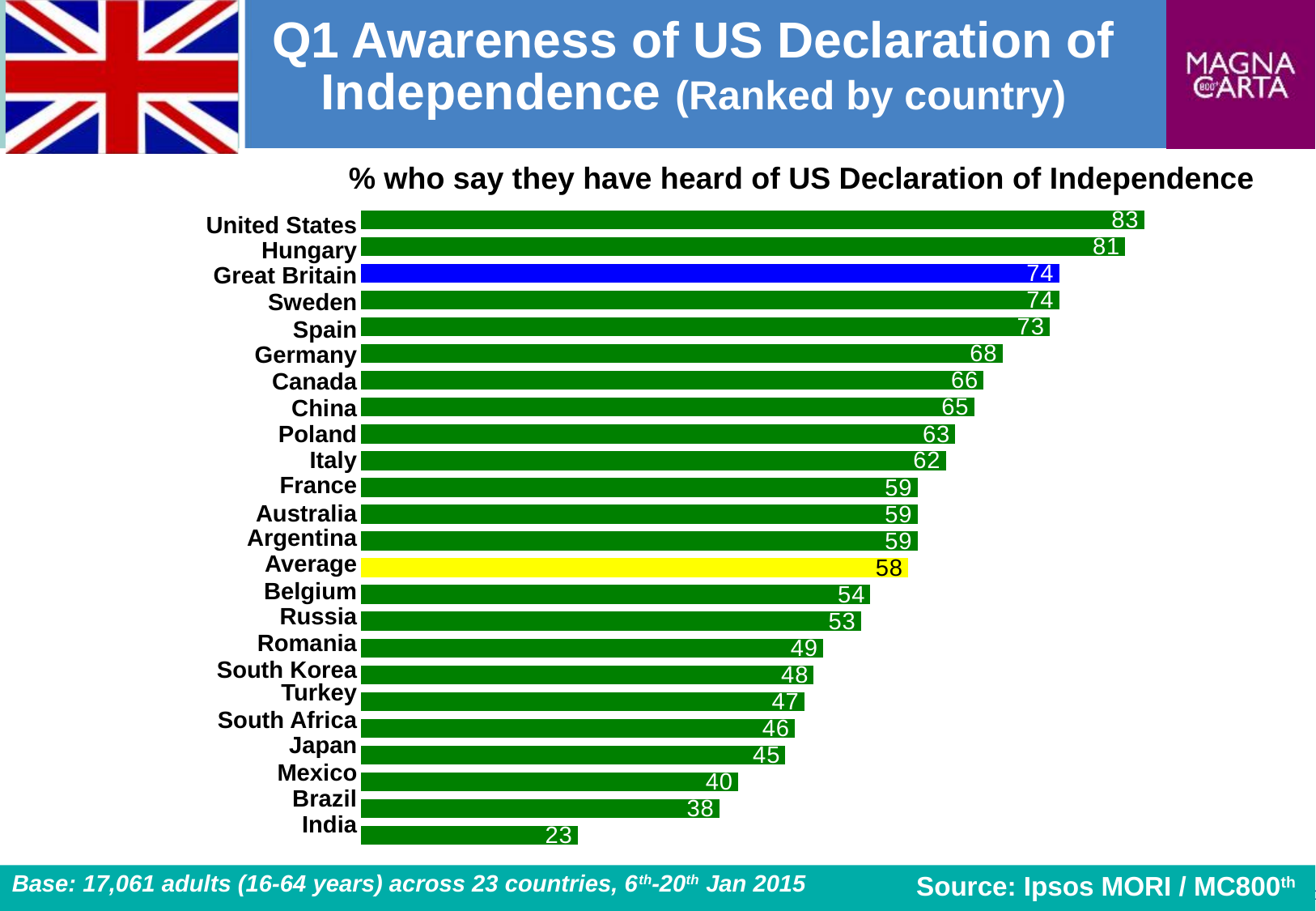
Which bar on the chart is coloured yellow? Average How many bars are plotted on the chart, including the Average bar? 24 What is the difference between the values for the United States and India? 60 What is the value shown for Japan? 45 Which has a larger value, Canada or Belgium? Canada Which country has the lowest value on the chart? India What is the value shown for the United States? 83 What is the difference between the values for Hungary and Germany? 13 Which country has the highest value on the chart? United States What kind of chart is shown on the slide? Bar chart What is the value shown for Great Britain? 74 What is the value shown for the Average bar? 58